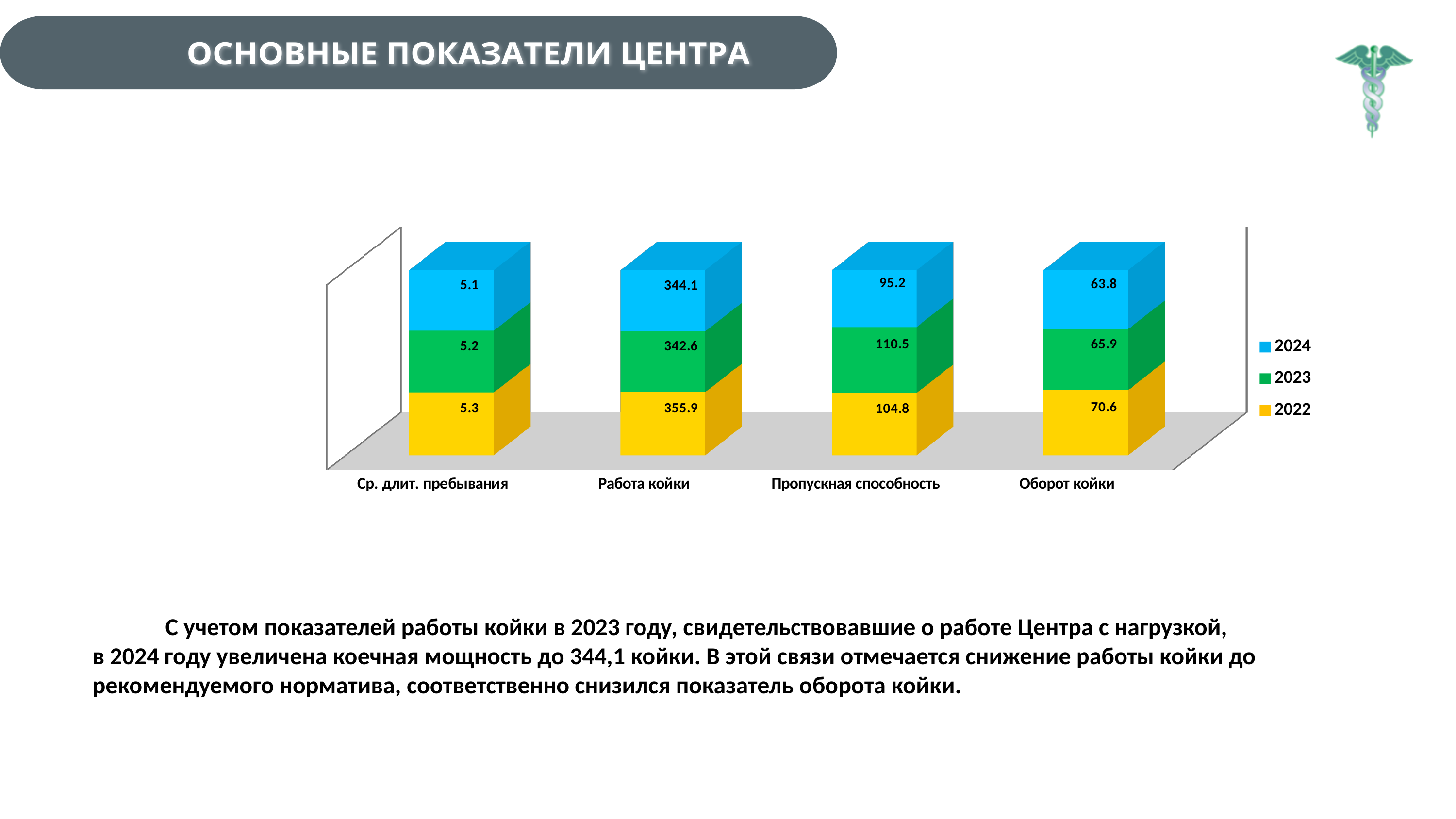
What is the difference between the 2023 and 2024 values for Пропускная способность? 15.3 How many series does the legend list? 3 What is the value for Ср. длит. пребывания in 2023? 5.2 How many categories are shown on the x axis? 4 What is the difference between the 2022 and 2024 values for Работа койки? 11.8 Which is larger for Оборот койки: the 2023 value or the 2024 value? 2023 In which year was Пропускная способность lowest? 2024 What is the value for Пропускная способность in 2023? 110.5 What is the value for Работа койки in 2024? 344.1 What kind of chart is shown on the slide? Stacked bar chart What is the value for Оборот койки in 2022? 70.6 In which year was Оборот койки highest? 2022